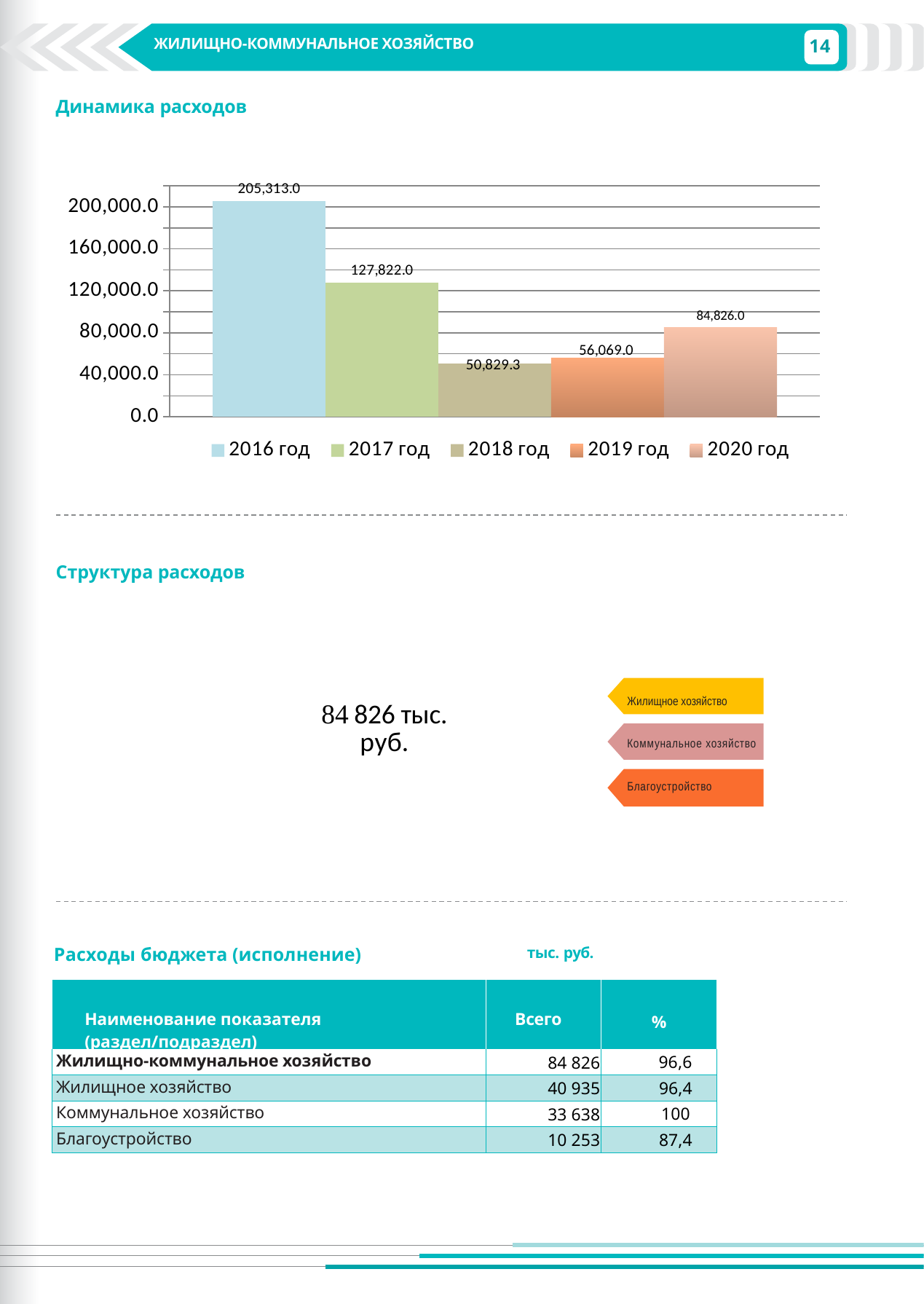
In the 'Динамика расходов' chart, which year has the lowest value? 2018 год What type of chart is 'Динамика расходов'? bar chart In the 'Динамика расходов' chart, which year has the highest value? 2016 год How many entries does the legend of the 'Динамика расходов' chart list? 5 How many bars are shown in the 'Динамика расходов' chart? 5 In the 'Динамика расходов' chart, what is the value for 2020 год? 84,826.0 In the 'Динамика расходов' chart, what is the difference between the values for 2020 год and 2019 год? 28,757.0 In the 'Динамика расходов' chart, what is the value for 2016 год? 205,313.0 In the 'Динамика расходов' chart, which is larger: the value for 2019 год or 2018 год? 2019 год In the 'Динамика расходов' chart, what is the difference between the values for 2016 год and 2017 год? 77,491.0 In the 'Динамика расходов' chart, is the value for 2017 год greater or less than 120,000.0? greater In the 'Динамика расходов' chart, what is the value for 2018 год? 50,829.3